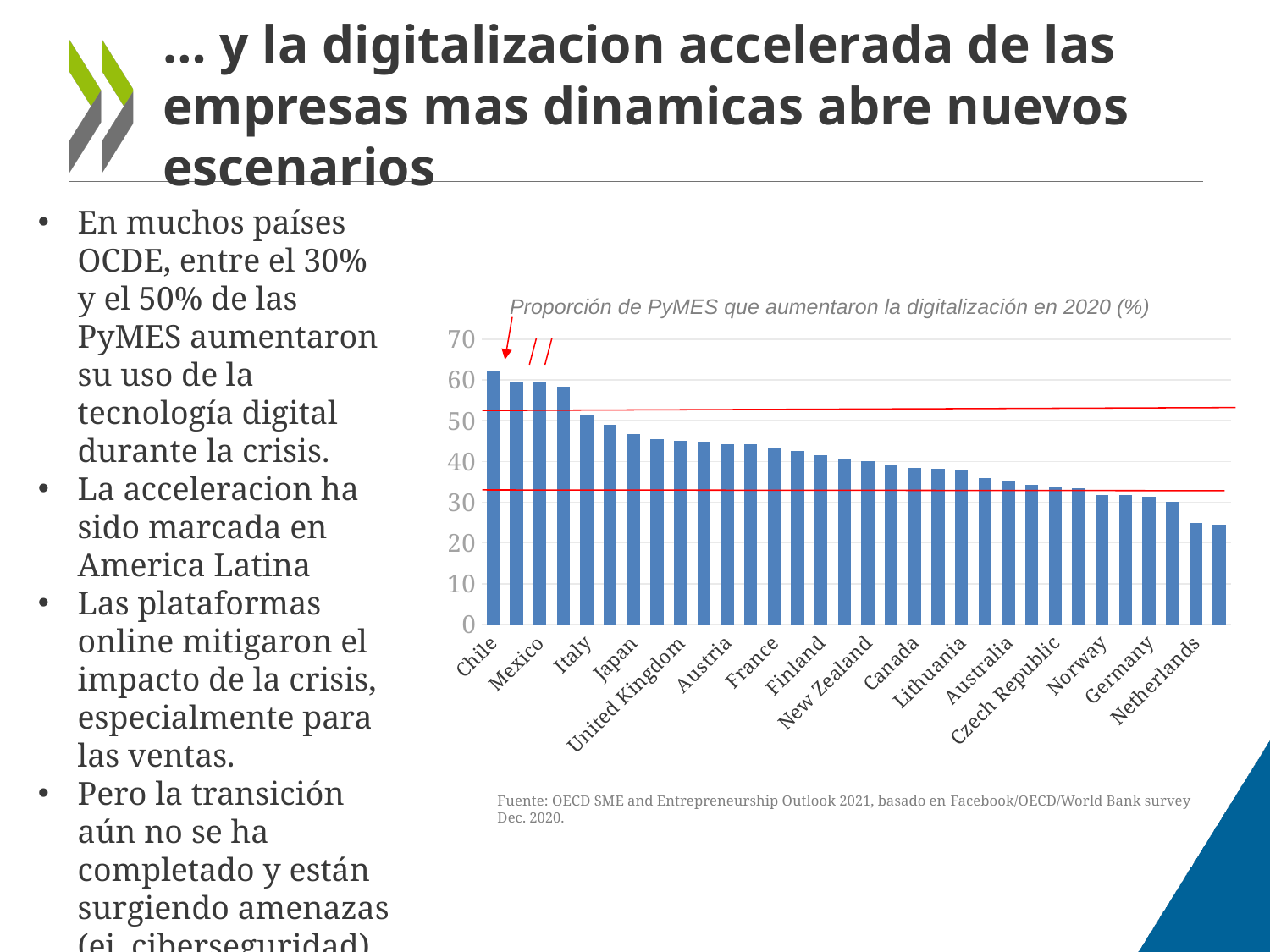
Is the value for Czech Republic greater or less than 30? greater Which has a larger value, Chile or Netherlands? Chile Is the value for United Kingdom greater or less than 40? greater Do the values rise or fall from left to right across the chart? Fall Which country has the highest value in the chart? Chile Is the value for Lithuania greater or less than 40? less What kind of chart is shown on the slide? Bar chart What is the title of the chart? Proporción de PyMES que aumentaron la digitalización en 2020 (%) Which has a larger value, Japan or Germany? Japan